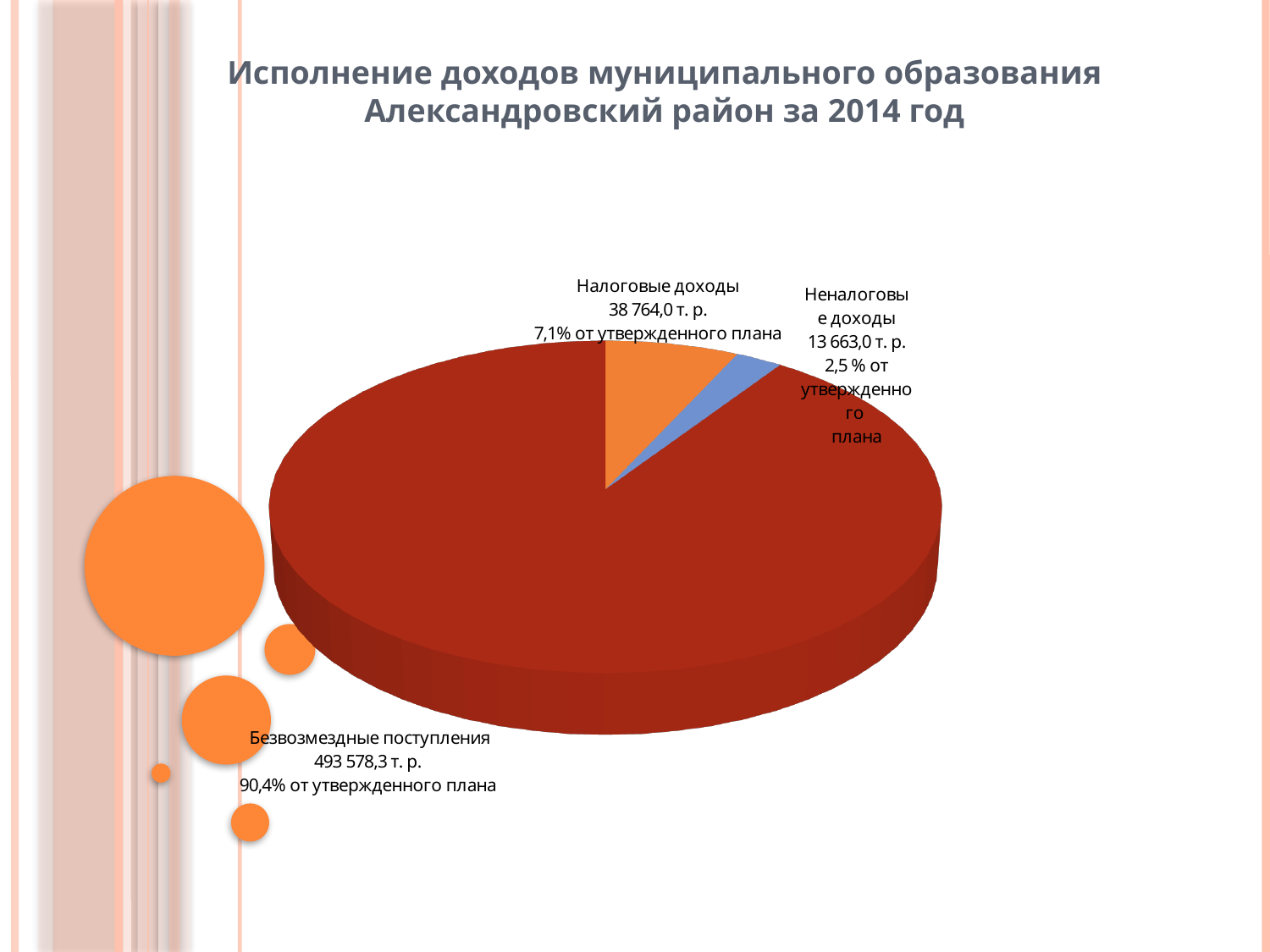
What is the difference between Налоговые доходы and Неналоговые доходы? 25 101,0 т. р. What is the value shown for Безвозмездные поступления? 493 578,3 т. р. What is the value shown for Неналоговые доходы? 13 663,0 т. р. What is the title of the slide containing the chart? Исполнение доходов муниципального образования Александровский район за 2014 год How many slices does the pie chart have? 3 What percentage is shown for Неналоговые доходы? 2,5 % What percentage is shown for Безвозмездные поступления? 90,4% What kind of chart is shown on the slide? pie chart What is the value shown for Налоговые доходы? 38 764,0 т. р. Which category has the smallest slice of the pie? Неналоговые доходы Which is larger, Налоговые доходы or Неналоговые доходы? Налоговые доходы Which category has the largest slice of the pie? Безвозмездные поступления